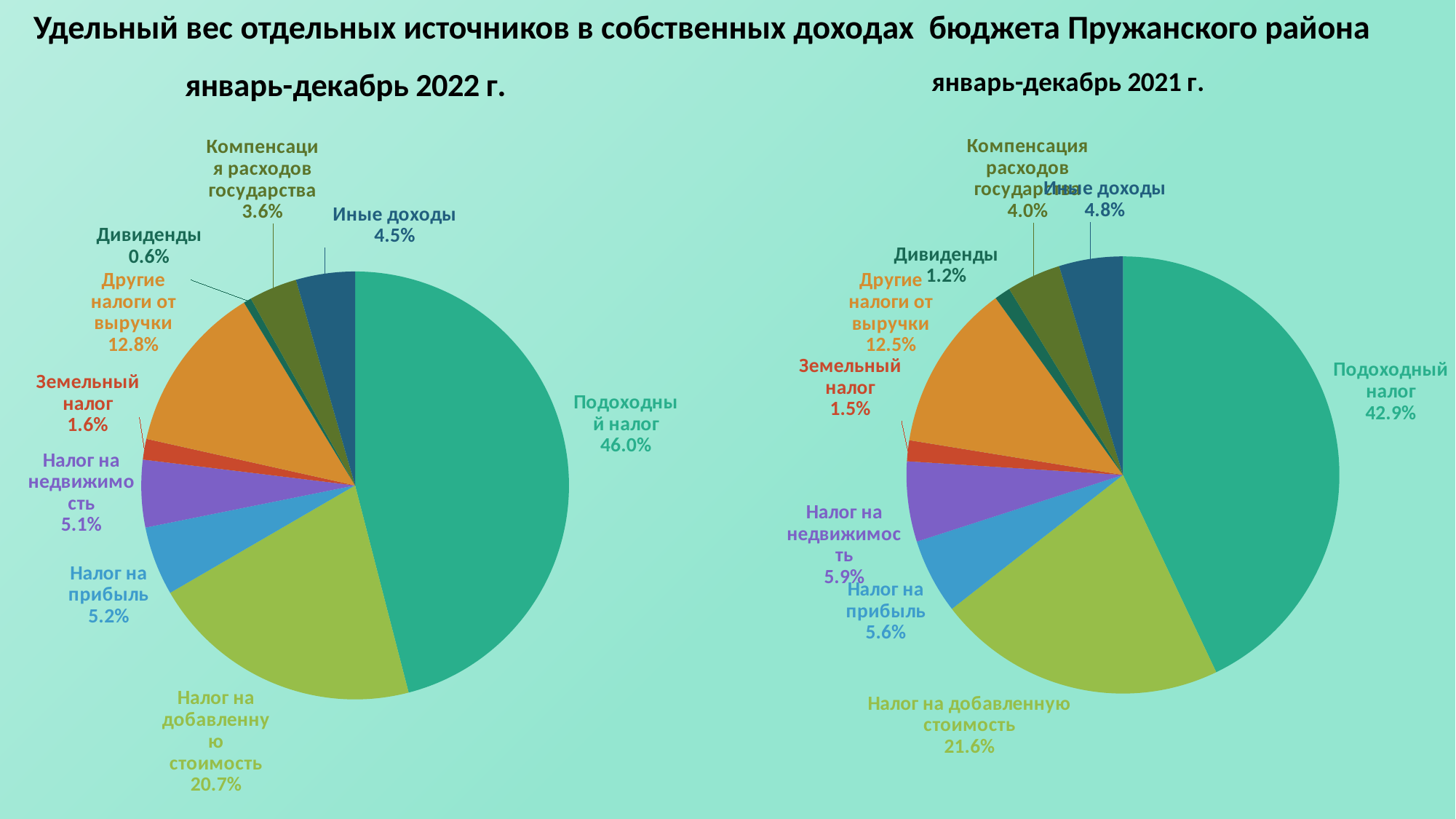
In the 'январь-декабрь 2022 г.' chart, what is the value for 'Другие налоги от выручки'? 12.8% In the 'январь-декабрь 2022 г.' chart, what share does 'Подоходный налог' have? 46.0% What type of chart is used on this slide? Pie chart How many categories are shown in the 'январь-декабрь 2022 г.' pie chart? 9 In the 'январь-декабрь 2021 г.' chart, what share does 'Налог на добавленную стоимость' have? 21.6% In the 'январь-декабрь 2022 г.' chart, what is the difference between 'Налог на добавленную стоимость' and 'Другие налоги от выручки'? 7.9% In the 'январь-декабрь 2021 г.' chart, what is the value for 'Иные доходы'? 4.8% In the 'январь-декабрь 2021 г.' chart, which category has the largest share? Подоходный налог In the 'январь-декабрь 2021 г.' chart, which is larger: 'Налог на недвижимость' or 'Налог на прибыль'? Налог на недвижимость What is the difference between the 'Подоходный налог' share in the 2022 chart and in the 2021 chart? 3.1% In the 'январь-декабрь 2022 г.' chart, which category has the smallest share? Дивиденды In the 'январь-декабрь 2021 г.' chart, what is the value for 'Дивиденды'? 1.2%